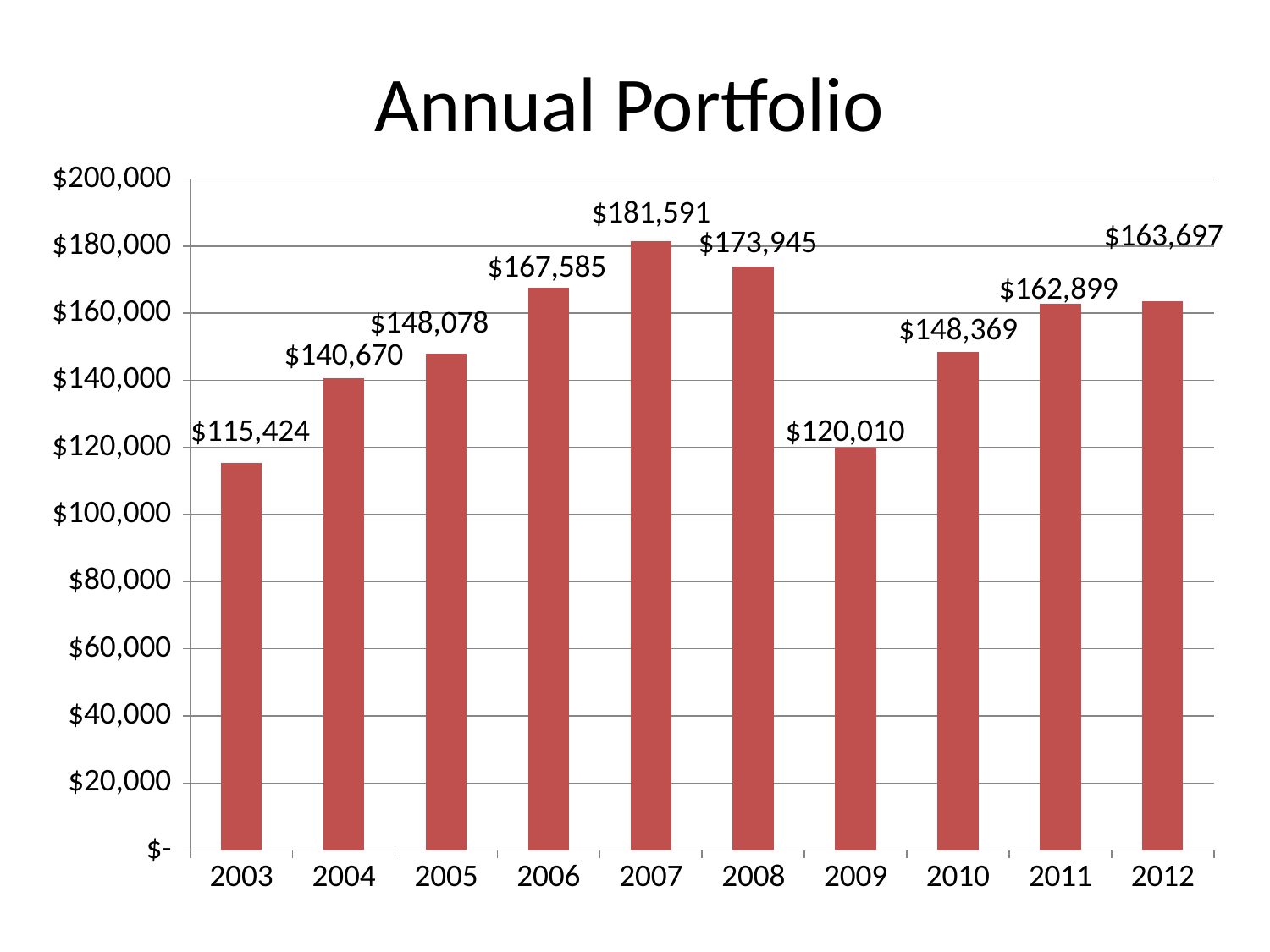
What is the difference between the portfolio values for 2008 and 2009? $53,935 What is the portfolio value for 2007? $181,591 What kind of chart is shown on the slide? bar chart What is the portfolio value for 2003? $115,424 Which year has the lowest portfolio value? 2003 What is the difference between the portfolio values for 2012 and 2011? $798 Which year has the highest portfolio value? 2007 What is the title of the chart? Annual Portfolio How many years are shown on the chart? 10 What is the portfolio value for 2010? $148,369 Which year has a larger portfolio value, 2006 or 2008? 2008 Is the portfolio value for 2009 greater or less than $140,000? less